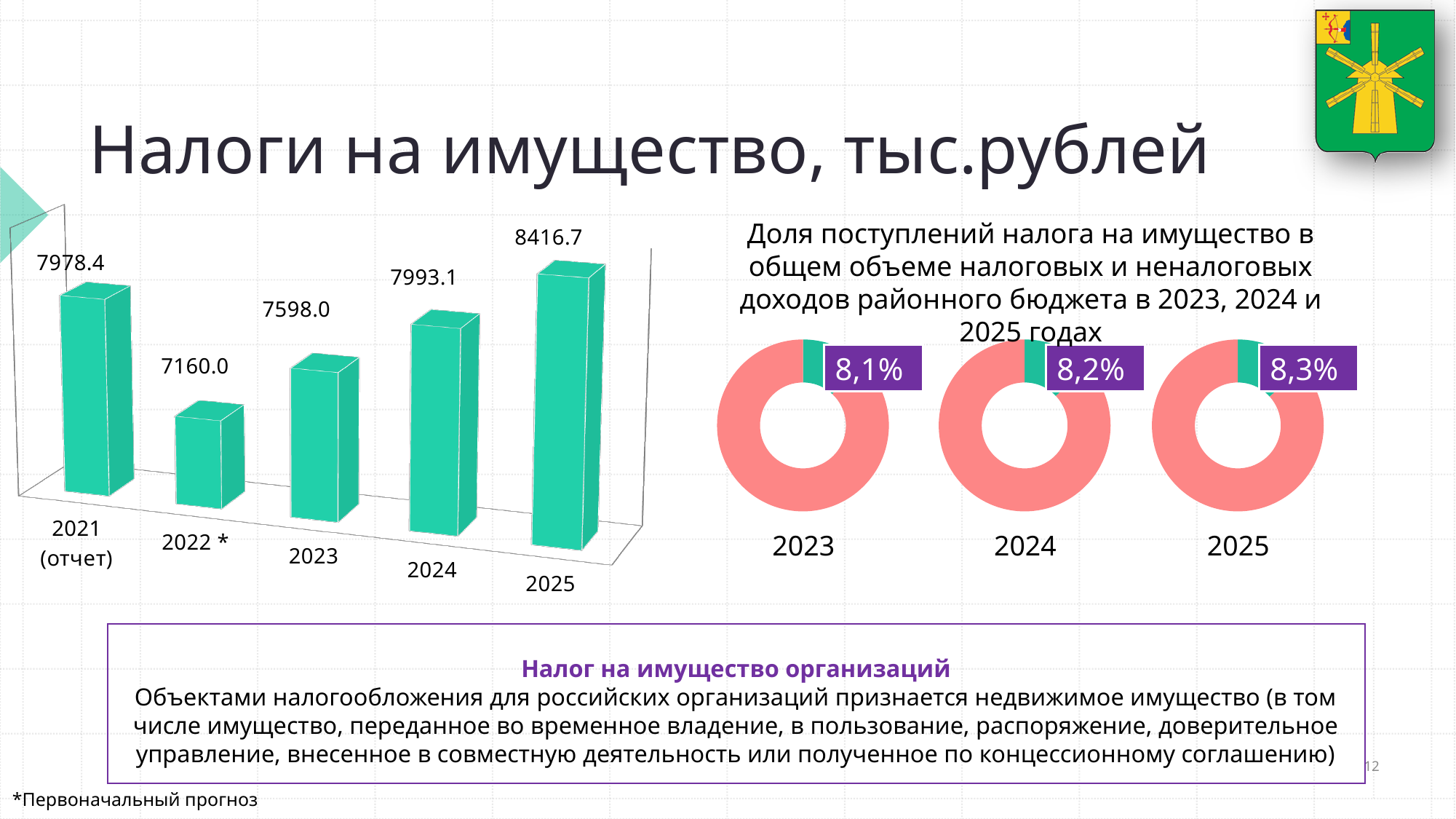
In the bar chart on the left, which year has the highest value? 2025 In the bar chart on the left, what is the difference between the values for 2025 and 2024? 423.6 In the bar chart on the left, which year has the lowest value? 2022 * What kind of chart is shown on the left of the slide? bar chart In the bar chart on the left, what is the value for 2023? 7598.0 In the bar chart on the left, what is the value for 2025? 8416.7 In the bar chart on the left, which is larger: the value for 2021 (отчет) or the value for 2024? 2024 How many donut charts are shown on the right side of the slide? 3 In the bar chart on the left, what is the value for 2021 (отчет)? 7978.4 How many bars are in the bar chart on the left? 5 In the donut chart for 2024 on the right, what share is shown for the property tax? 8,2% In the bar chart on the left, do the values rise or fall from 2022 * to 2025? rise